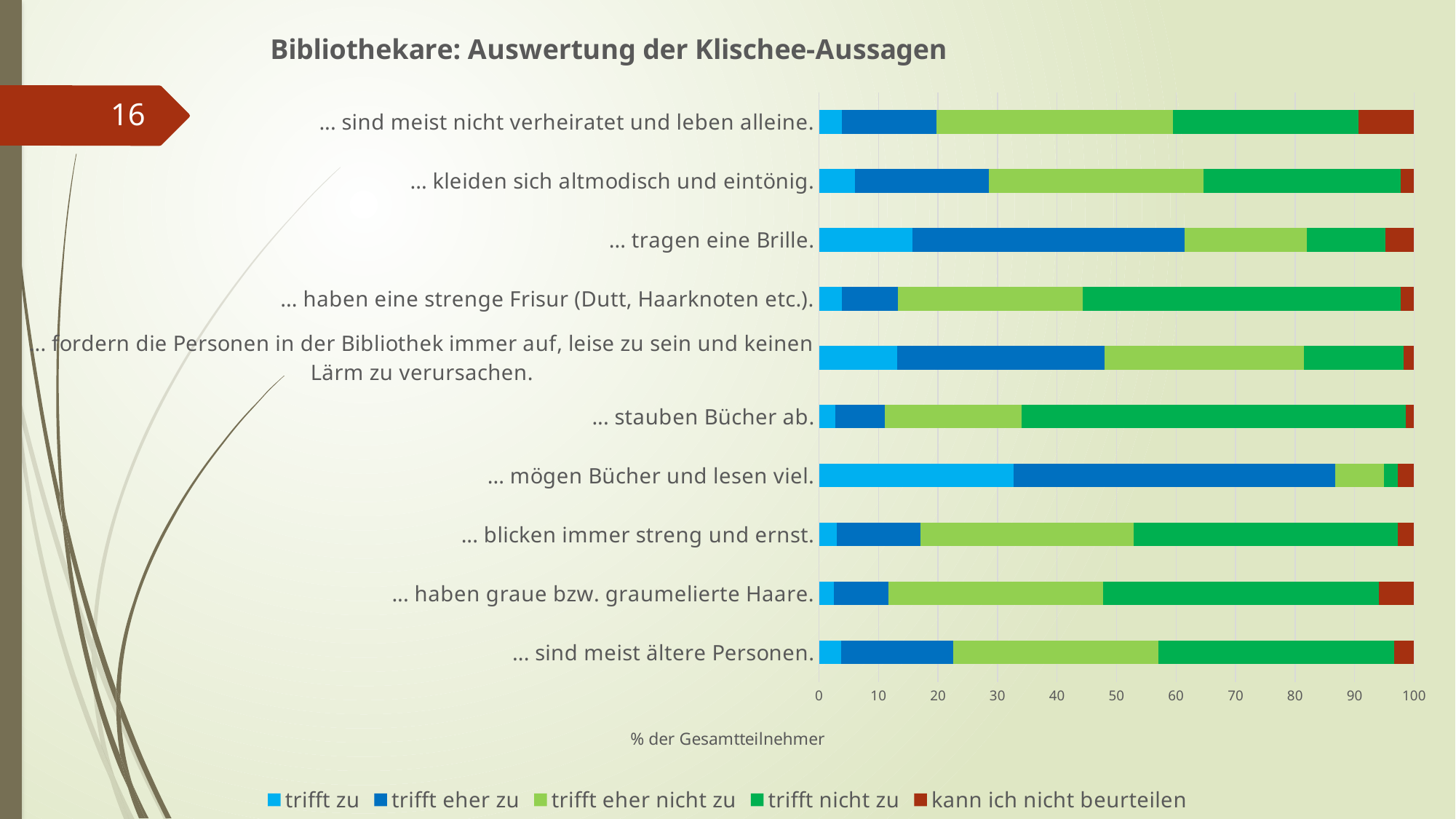
What is the title of the chart? Bibliothekare: Auswertung der Klischee-Aussagen Is the "trifft nicht zu" value for "... stauben Bücher ab." greater or less than 50? greater Which statement has the largest "kann ich nicht beurteilen" segment? ... sind meist nicht verheiratet und leben alleine. How many statements (categories) are plotted in the chart? 10 How many series does the legend list? 5 What kind of chart is shown on the slide? stacked bar chart Which has the larger "trifft eher zu" segment: "... tragen eine Brille." or "... sind meist ältere Personen."? ... tragen eine Brille. Which statement has the largest "trifft zu" segment? ... mögen Bücher und lesen viel. What is the label of the horizontal axis? % der Gesamtteilnehmer Is the "trifft zu" value for "... tragen eine Brille." greater or less than 10? greater Which statement has the largest "trifft nicht zu" segment? ... stauben Bücher ab. Is the "trifft zu" value for "... mögen Bücher und lesen viel." greater or less than 20? greater